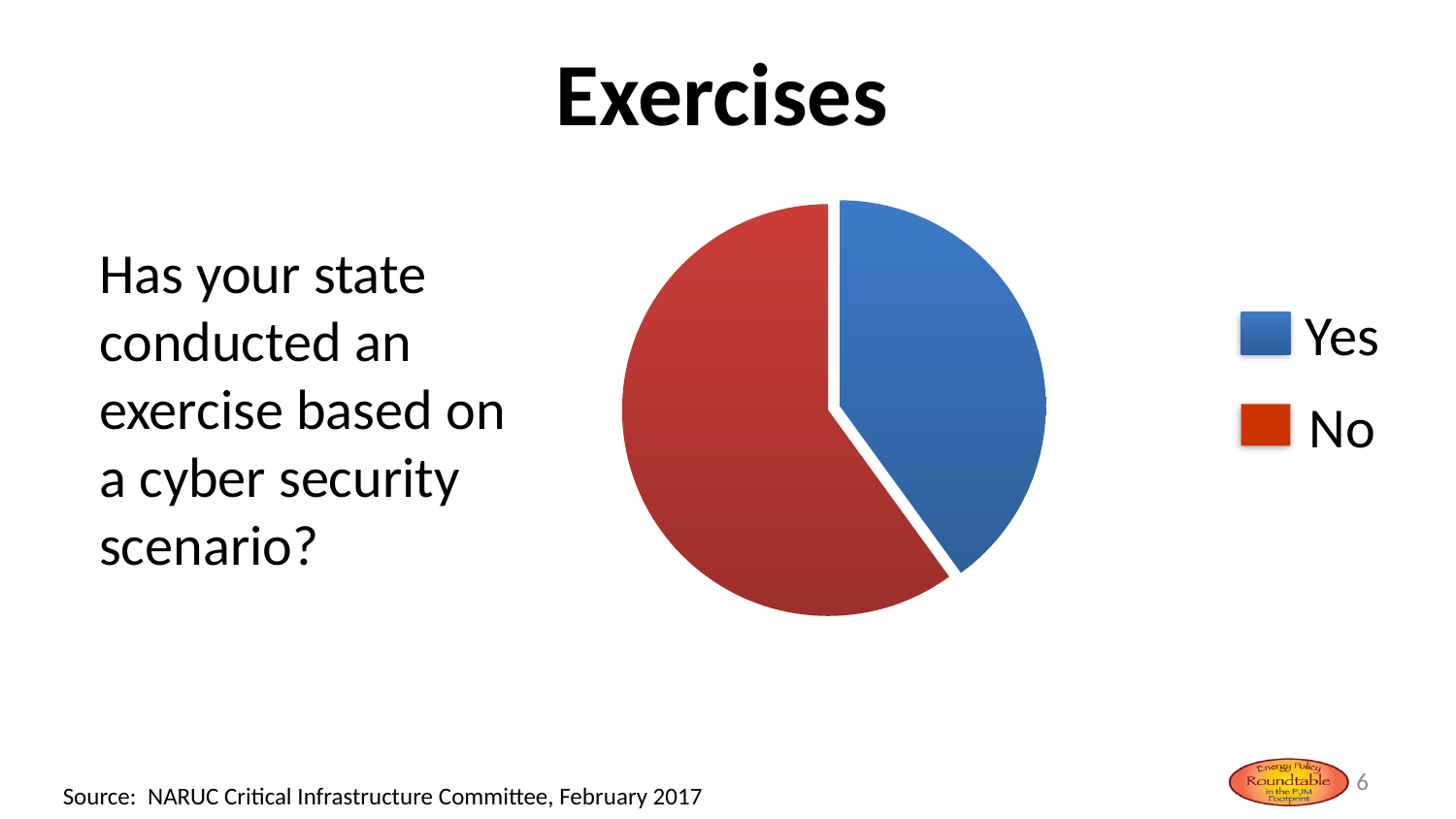
Is the share of the Yes slice greater or less than half of the pie? less How many slices does the pie chart have? 2 Is the share of the No slice greater or less than half of the pie? greater How many entries does the legend of the pie chart list? 2 Which category has the smallest slice in the pie chart? Yes Which category has the largest slice in the pie chart? No What colour is the No slice in the pie chart? red Which slice is larger in the pie chart, Yes or No? No What colour is the Yes slice in the pie chart? blue What kind of chart is shown on the slide? pie chart